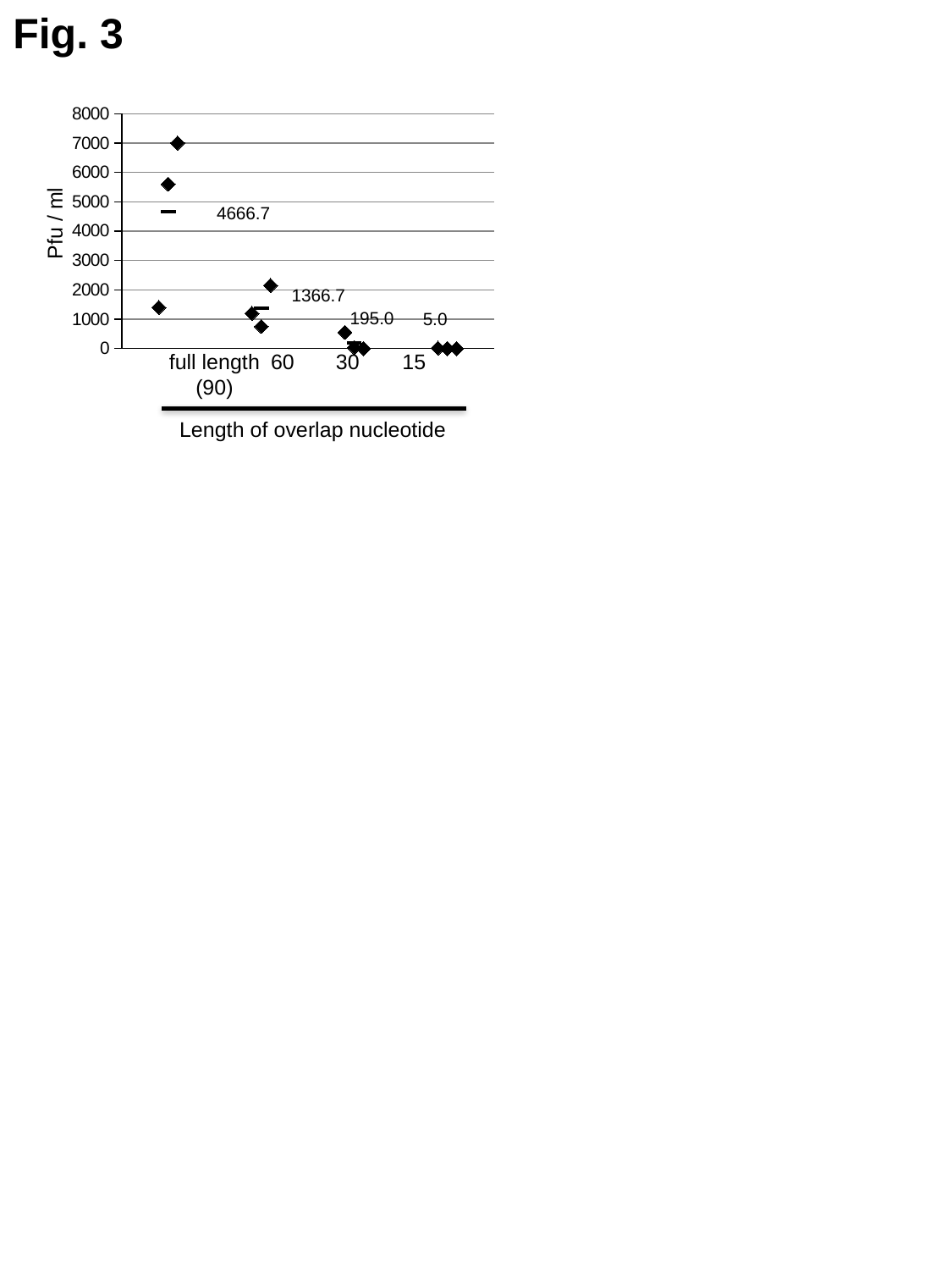
What is the difference between the labelled mean values for full length (90) and 60? 3300.0 What kind of chart is shown on the slide? scatter plot Which overlap length group has the lowest labelled mean value? 15 Do the labelled mean values rise or fall as the overlap length decreases from full length (90) to 15? fall Which has a larger labelled mean value, the 60 group or the 30 group? 60 How many overlap length groups are shown on the x axis? 4 What is the labelled mean value for the 30 overlap length group? 195.0 What is the labelled mean value for the full length (90) group? 4666.7 Which overlap length group has the highest labelled mean value? full length (90) Is the highest plotted point for the full length (90) group greater or less than 6000? greater What is the labelled mean value for the 15 overlap length group? 5.0 What is the labelled mean value for the 60 overlap length group? 1366.7